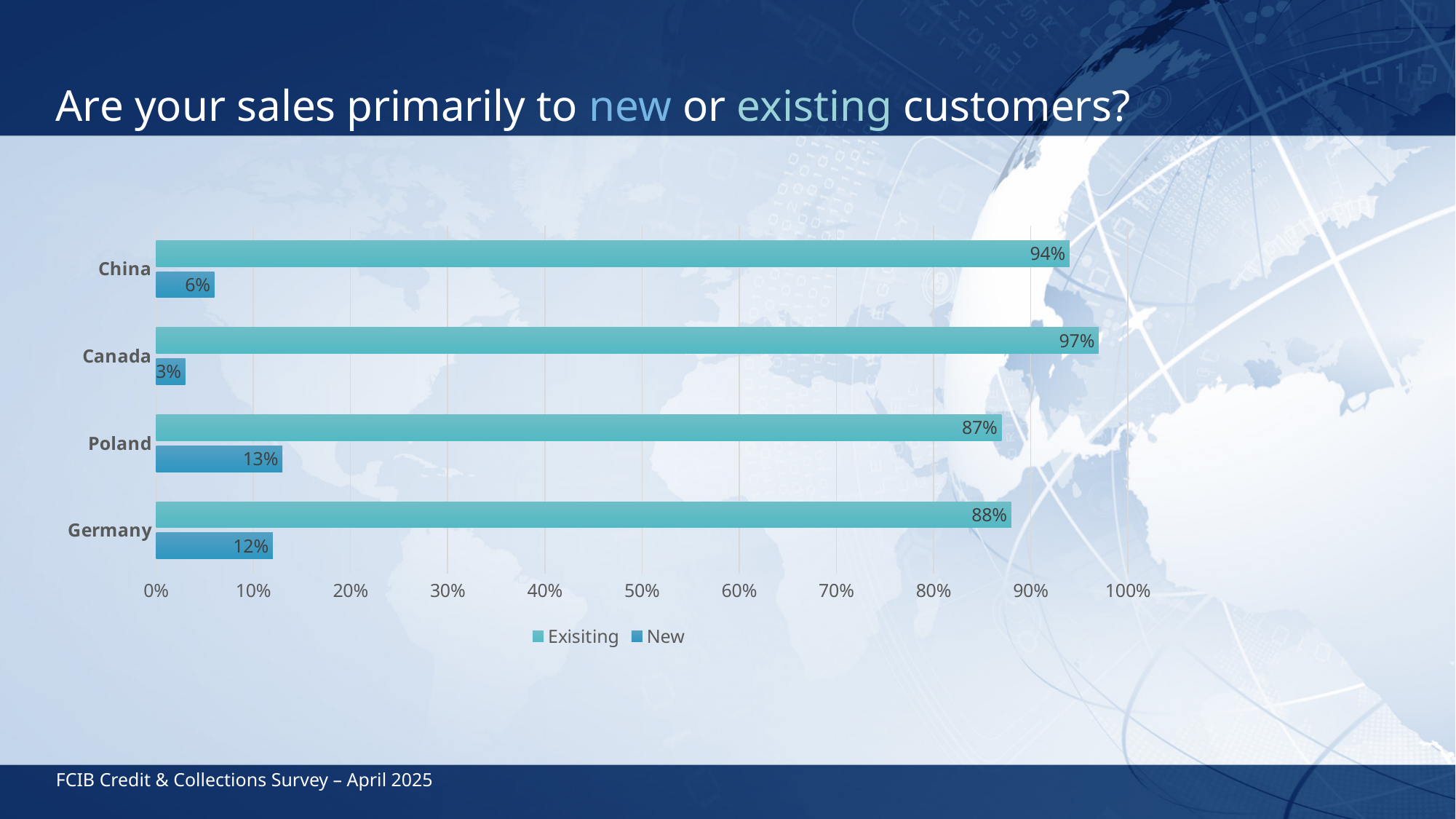
Is the existing customer value for Poland greater or less than 80%? greater What is the value for new customers in China? 6% What type of chart is shown on the slide? Bar chart Which country has the lowest share of sales to new customers? Canada What is the difference between the existing and new customer percentages for Germany? 76% What percentage of sales in Canada are to existing customers? 97% What are the two series named in the legend? Exisiting and New Which is larger: the new customer share for Poland or for Germany? Poland Which country has the highest share of sales to existing customers? Canada What percentage of sales in Poland are to new customers? 13% How many countries are shown on the chart? 4 How many series does the legend list? 2